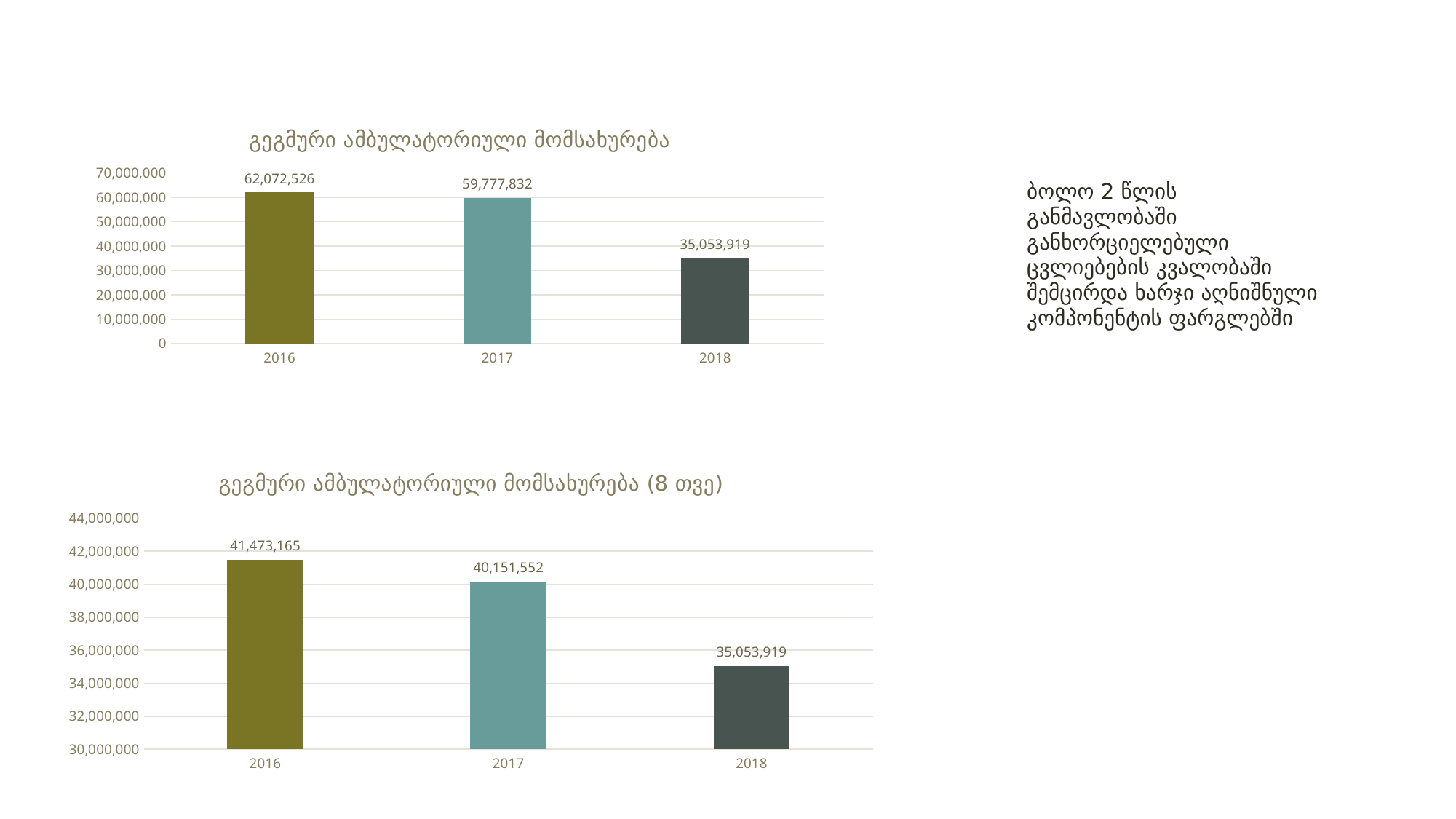
In the bottom chart (8 თვე), do the values rise or fall from 2016 to 2018? Fall In the top chart, what is the value for 2016? 62,072,526 In the top chart, which is larger, the value for 2016 or the value for 2017? 2016 In the bottom chart (8 თვე), what is the difference between the 2016 and 2017 values? 1,321,613 In the top chart, which year has the lowest value? 2018 In the top chart, what is the value for 2018? 35,053,919 In the bottom chart (8 თვე), what is the value for 2017? 40,151,552 How many years are shown on the x axis of the bottom chart (8 თვე)? 3 What kind of chart is the top chart? Bar chart In the bottom chart (8 თვე), what is the value for 2016? 41,473,165 In the top chart, what is the difference between the 2017 and 2018 values? 24,723,913 In the bottom chart (8 თვე), which year has the highest value? 2016